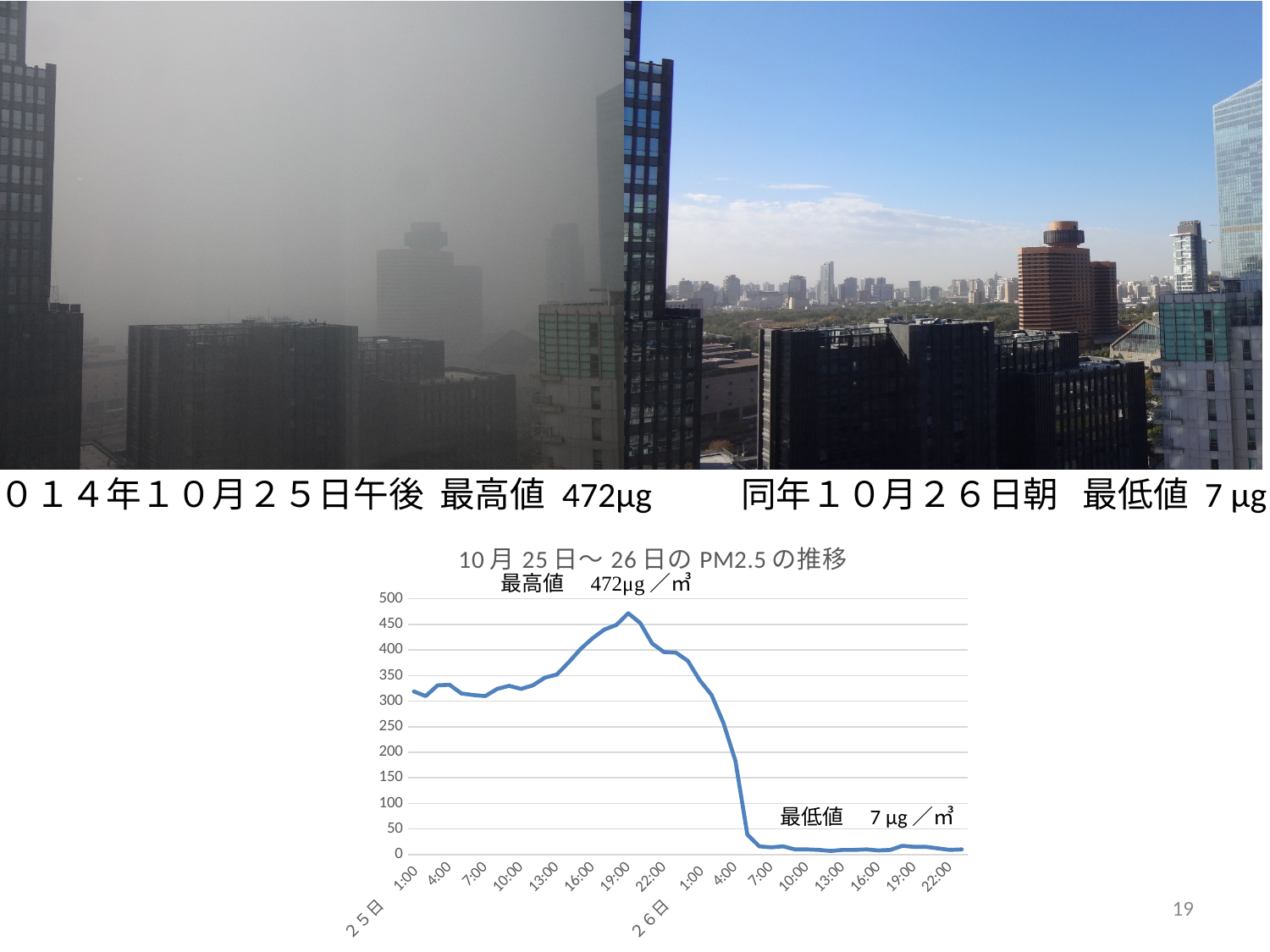
Is the PM2.5 value at 7:00 on 26日 greater or less than 50? less What is the maximum PM2.5 value (最高値) labelled on the chart? 472μg／㎥ Does the PM2.5 value rise or fall between 19:00 on 25日 and 7:00 on 26日? fall What is the title of the chart? 10月25日～26日のPM2.5の推移 Is the PM2.5 value at 16:00 on 25日 greater or less than 350? greater Is the PM2.5 value at 19:00 on 25日 greater or less than 400? greater Which is larger, the PM2.5 value at 19:00 on 25日 or at 19:00 on 26日? 19:00 on 25日 What kind of chart is shown on the slide? line chart What is the difference between the labelled maximum (最高値) and minimum (最低値) PM2.5 values? 465μg／㎥ What is the highest value shown on the vertical axis of the chart? 500 What is the minimum PM2.5 value (最低値) labelled on the chart? 7μg／㎥